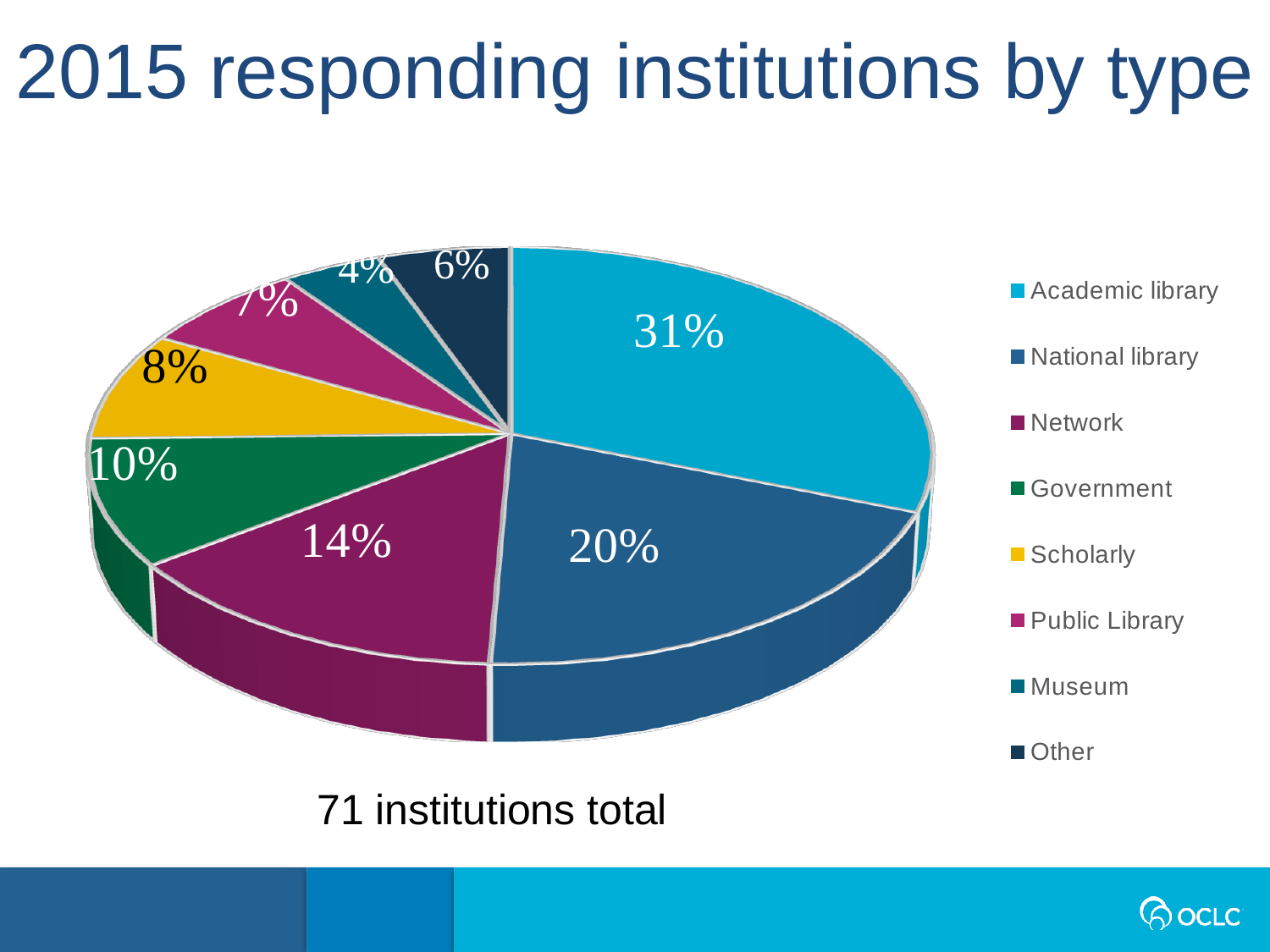
What is the value for Government? 10% What share of the pie does National library represent? 20% What is the difference between the shares for Academic library and National library? 11% Which institution type has the largest share of the pie? Academic library Which is larger, the share for Government or the share for Scholarly? Government What share of the pie does Academic library represent? 31% What is the value for Network? 14% Which institution type has the smallest share of the pie? Museum What is the value for Scholarly? 8% How many institution types does the legend list? 8 What kind of chart is shown on the slide? pie chart What is the value for Other? 6%